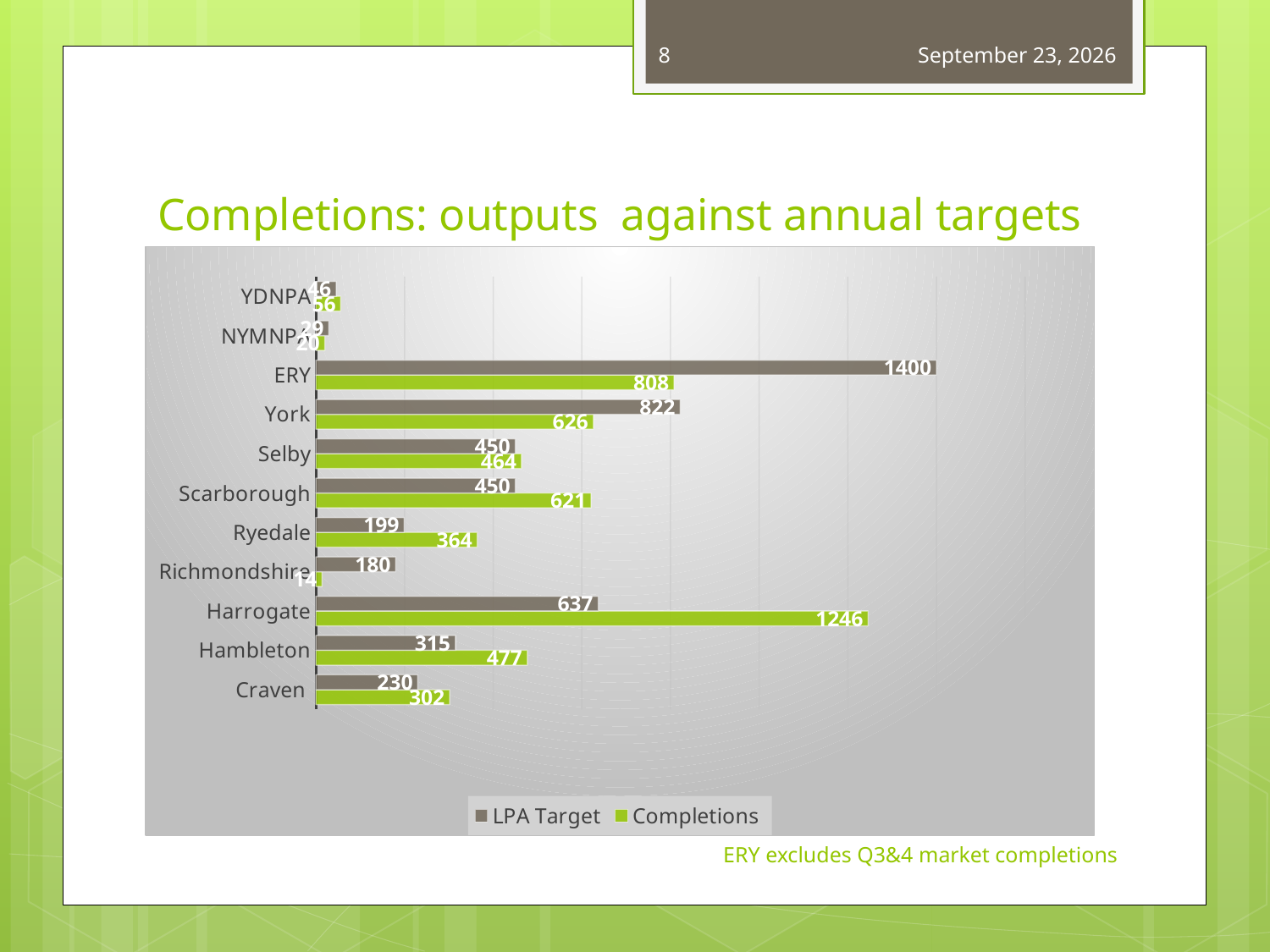
Which category has the highest Completions value? Harrogate How many categories are shown on the chart? 11 What is the difference between the LPA Target and Completions for ERY? 592 By how much do Completions exceed the LPA Target for Harrogate? 609 What is the Completions value for York? 626 How many series does the legend list? 2 Which category has the highest LPA Target? ERY What is the LPA Target value for ERY? 1400 For Scarborough, which is larger: the LPA Target or Completions? Completions What is the Completions value for Harrogate? 1246 What is the LPA Target value for Ryedale? 199 What kind of chart is shown on the slide? Bar chart